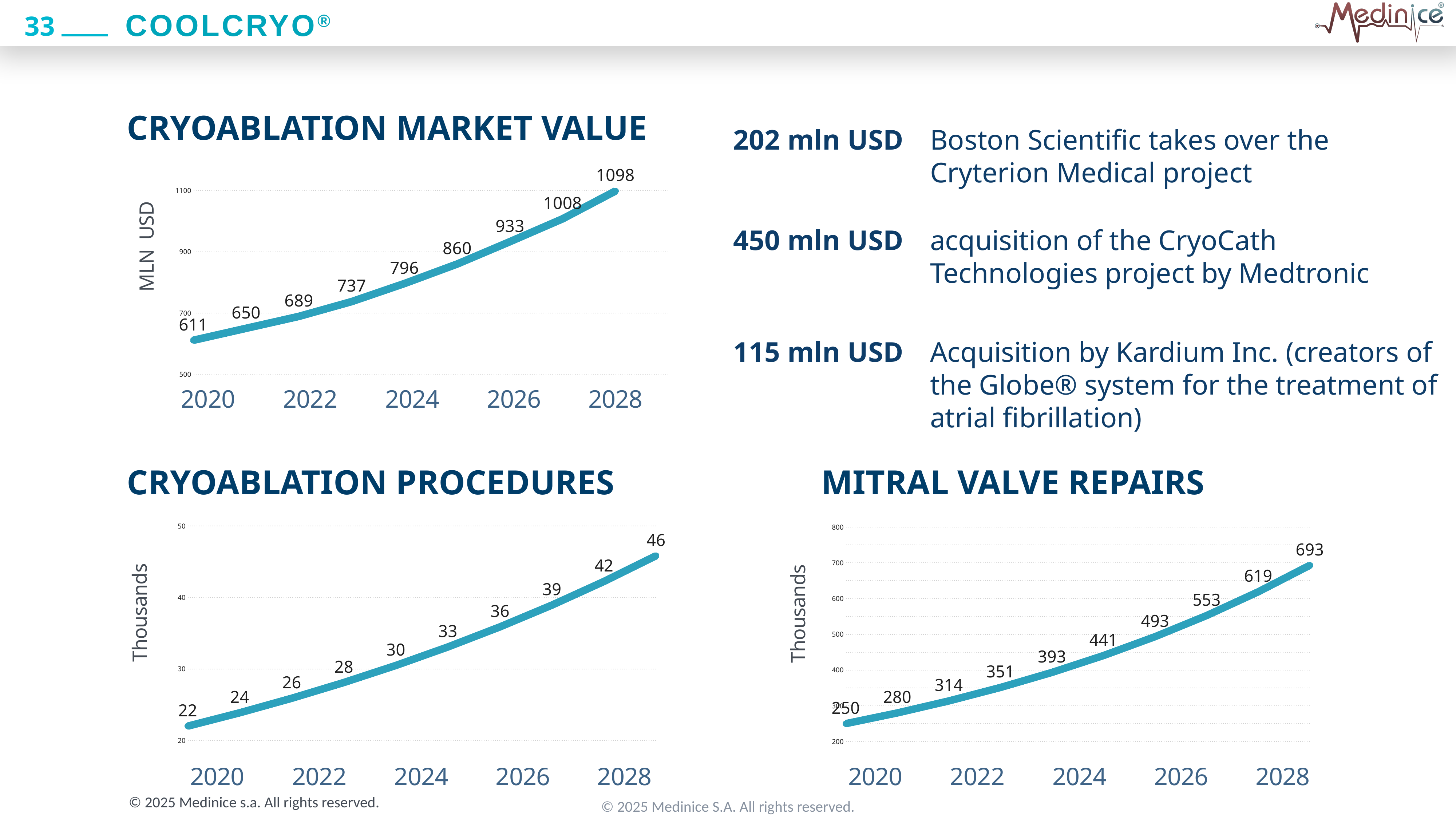
In the Cryoablation Procedures chart, what is the highest value shown? 46 In the Cryoablation Market Value chart, what is the value for 2020? 611 What kind of chart is the Cryoablation Procedures chart? line chart In the Mitral Valve Repairs chart, what is the highest value shown? 693 In the Cryoablation Market Value chart, what is the value for 2028? 1098 In the Mitral Valve Repairs chart, do the values rise or fall from left to right? rise In the Mitral Valve Repairs chart, what is the difference between the highest value (693) and the lowest value (250)? 443 In the Cryoablation Market Value chart, what is the difference between the 2028 value and the 2020 value? 487 In the Cryoablation Market Value chart, what is the value for 2024? 796 In the Cryoablation Market Value chart, how many data points are plotted? 9 In the Cryoablation Procedures chart, what is the lowest value shown? 22 In the Cryoablation Market Value chart, what is the unit shown on the vertical axis? MLN USD